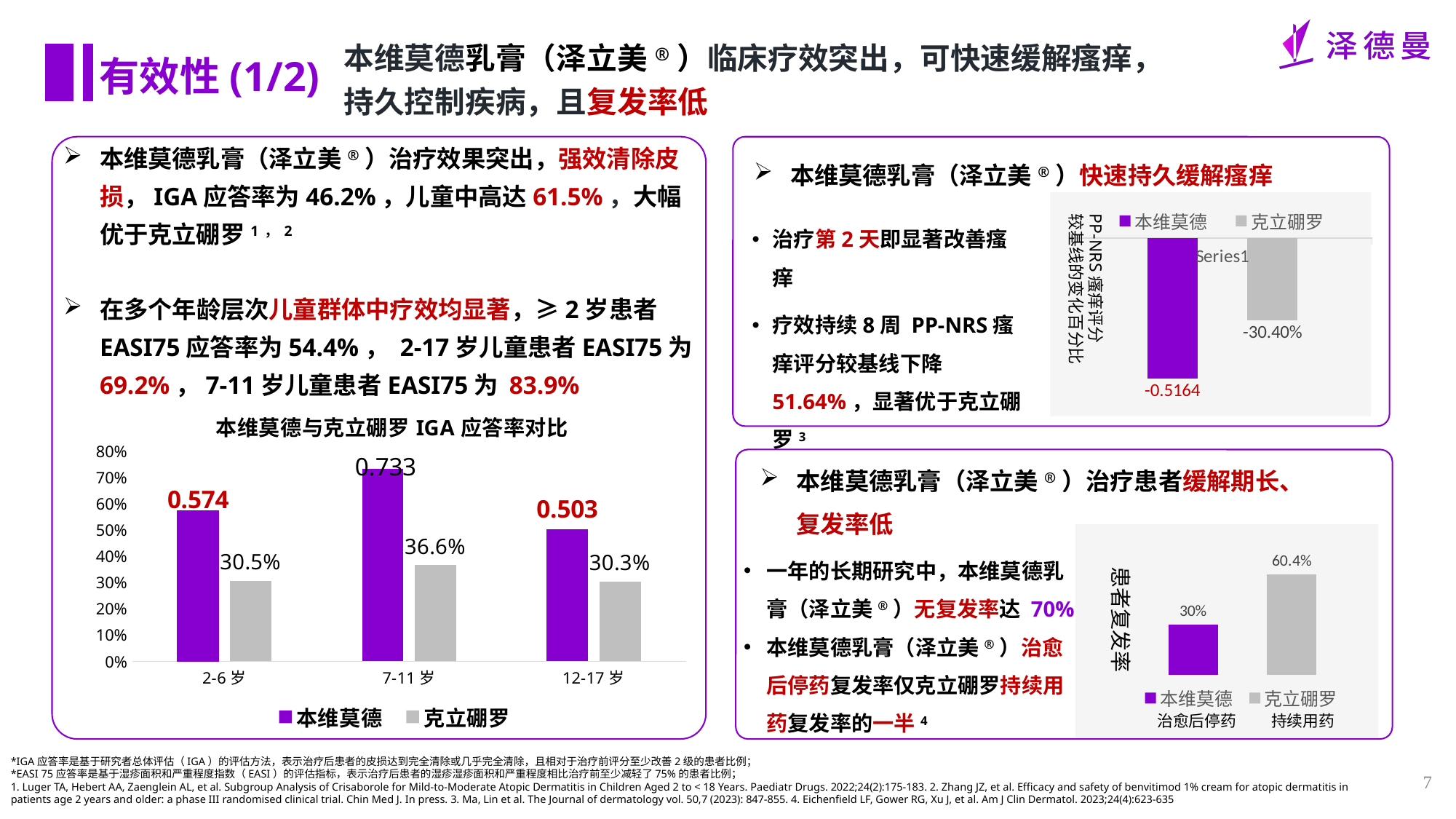
In the chart titled 本维莫德与克立硼罗 IGA 应答率对比, is the 克立硼罗 value for 7-11 岁 greater or less than 40%? less In the PP-NRS chart at the top right of the slide, what is the value for 克立硼罗? -30.40% In the chart titled 本维莫德与克立硼罗 IGA 应答率对比, which age group has the lowest 本维莫德 value? 12-17 岁 In the chart titled 本维莫德与克立硼罗 IGA 应答率对比, which age group has the highest 本维莫德 value? 7-11 岁 In the chart titled 本维莫德与克立硼罗 IGA 应答率对比, what is the value for 克立硼罗 in the 2-6 岁 group? 30.5% What kind of chart is the one titled 本维莫德与克立硼罗 IGA 应答率对比? bar chart In the chart titled 本维莫德与克立硼罗 IGA 应答率对比, how many age groups are shown on the x axis? 3 In the 患者复发率 chart at the bottom right of the slide, what is the value for 克立硼罗 持续用药? 60.4% In the 患者复发率 chart at the bottom right of the slide, what is the difference between the 克立硼罗 持续用药 value and the 本维莫德 治愈后停药 value? 30.4% In the PP-NRS chart at the top right of the slide, what is the value for 本维莫德? -0.5164 In the chart titled 本维莫德与克立硼罗 IGA 应答率对比, how many series does the legend list? 2 In the chart titled 本维莫德与克立硼罗 IGA 应答率对比, what is the value for 本维莫德 in the 7-11 岁 group? 0.733